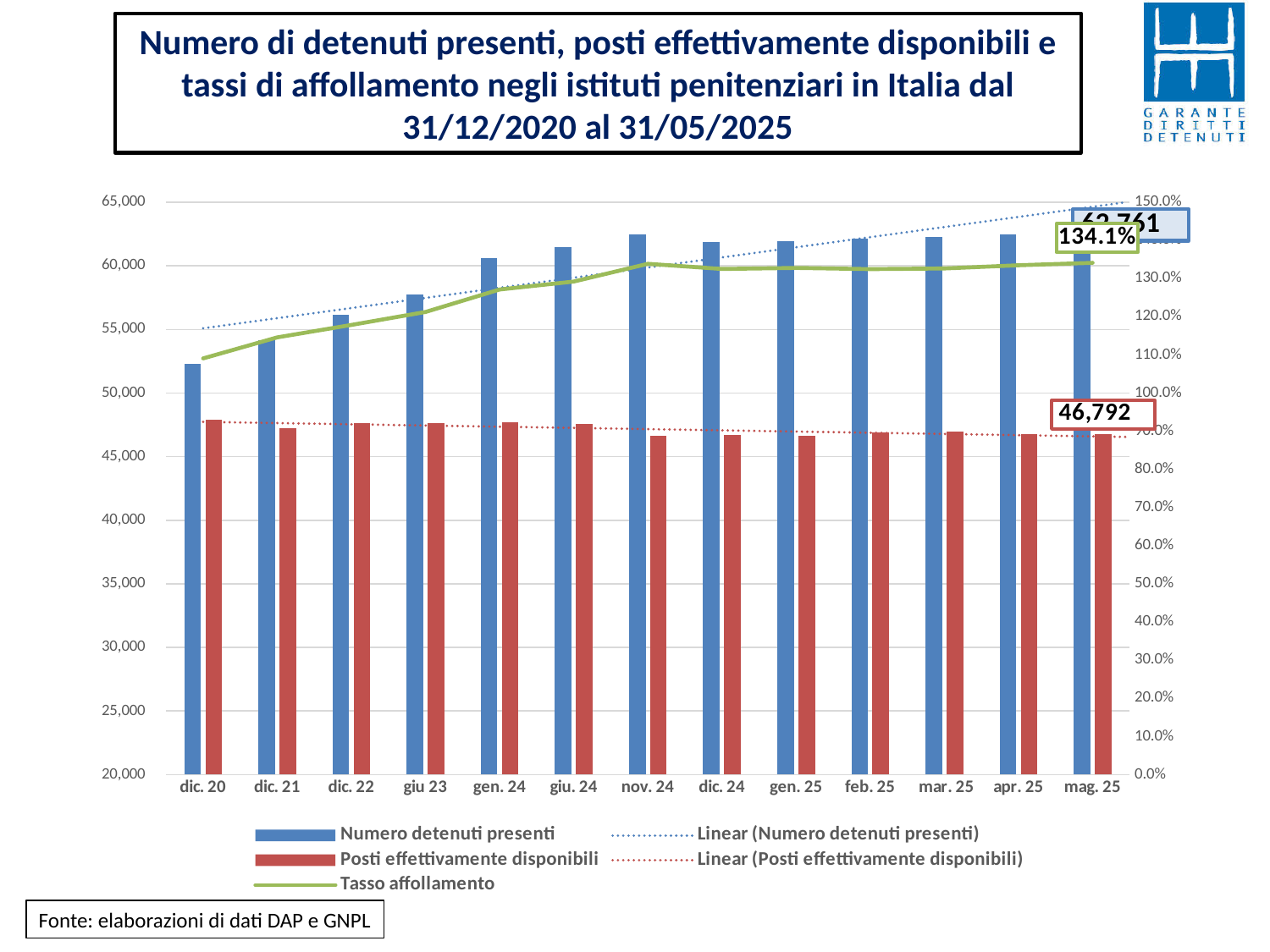
Is the value of Numero detenuti presenti for nov. 24 greater or less than 60,000? greater Is the Tasso affollamento for dic. 20 greater or less than 100.0%? greater What is the value of Numero detenuti presenti for mag. 25? 62,761 How many time periods are shown on the x axis? 13 How many entries does the legend list? 5 Does the Numero detenuti presenti series generally rise or fall from dic. 20 to mag. 25? rise What is the difference between Numero detenuti presenti and Posti effettivamente disponibili in mag. 25? 15,969 What is the Tasso affollamento for mag. 25? 134.1% Which is larger, Numero detenuti presenti in dic. 20 or in dic. 22? dic. 22 What is the value of Posti effettivamente disponibili for mag. 25? 46,792 Which period has the lowest value for Numero detenuti presenti? dic. 20 Is the value of Numero detenuti presenti for dic. 20 greater or less than 55,000? less